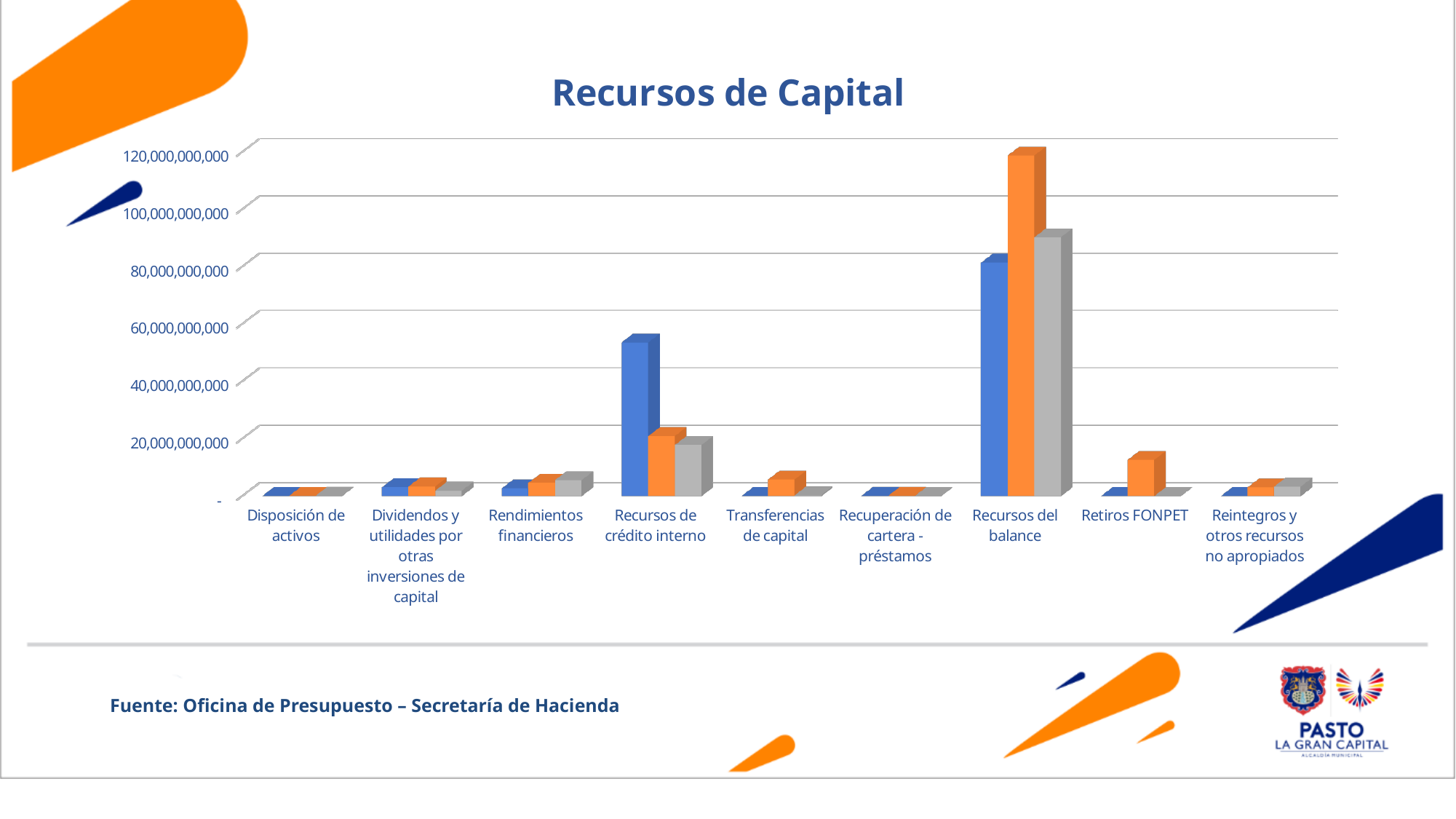
For Recursos de crédito interno, which is larger, the blue bar or the orange bar? the blue bar Is the orange bar for Retiros FONPET greater or less than 20,000,000,000? less Which category has the tallest blue bar? Recursos del balance How many bars are shown for each category in the chart? 3 Is the blue bar for Recursos de crédito interno greater or less than 40,000,000,000? greater What kind of chart is shown on the slide? bar chart Which category has the tallest orange bar? Recursos del balance Is the blue bar for Recursos de crédito interno greater or less than 60,000,000,000? less For Recursos del balance, which is larger, the orange bar or the gray bar? the orange bar What is the title of the chart? Recursos de Capital How many categories are shown on the x axis of the chart? 9